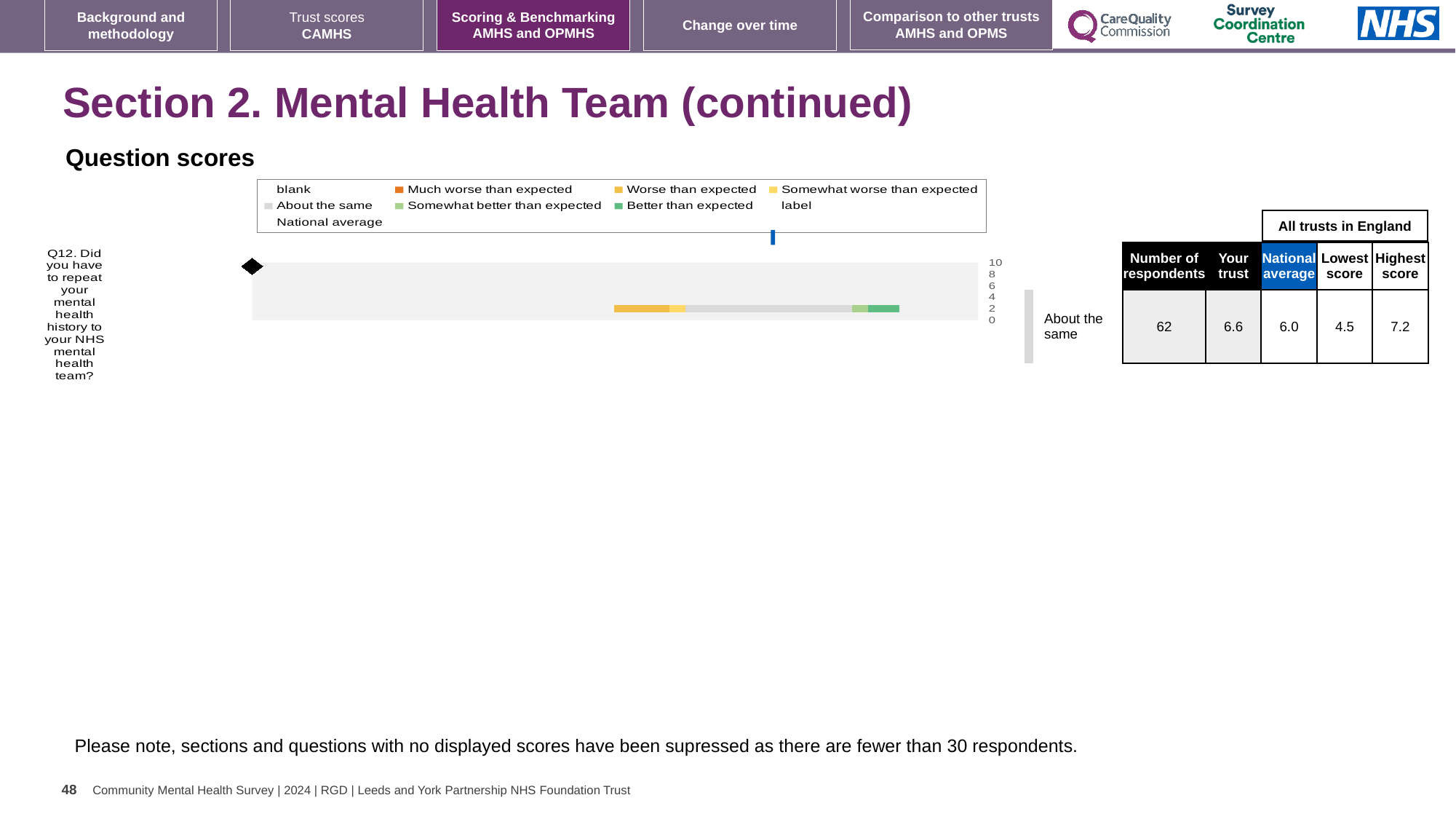
Which question is plotted in the Question scores chart? Q12. Did you have to repeat your mental health history to your NHS mental health team? For Q12, which is larger: the "Your trust" score or the national average? Your trust What is the "Your trust" score shown for Q12? 6.6 For Q12, what is the difference between the highest score and the lowest score among all trusts in England? 2.7 Which legend entry in the Question scores chart is shown in grey? About the same What is the highest score among all trusts in England shown for Q12? 7.2 How many survey questions are plotted in the Question scores chart? 1 What benchmark category is shown for Q12 next to the chart? About the same What is the number of respondents shown for Q12? 62 What is the national average score shown for Q12? 6.0 What is the lowest score among all trusts in England shown for Q12? 4.5 What kind of chart is shown under the heading "Question scores"? bar chart